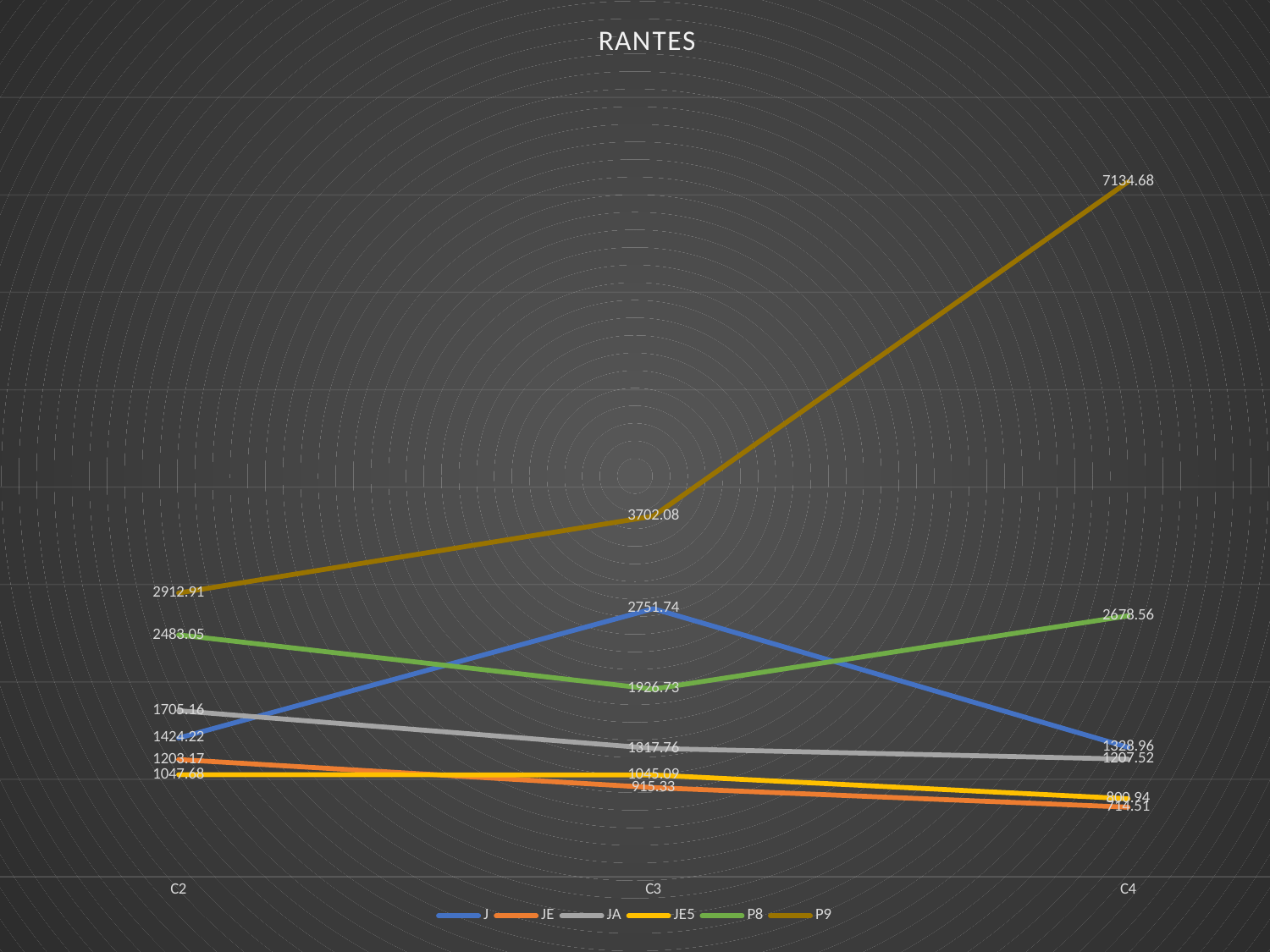
What is the value of J at C3? 2751.74 What is the value of P8 at C2? 2483.05 Which series has the lowest value at C4? JE What is the value of JA at C4? 1207.52 What is the value of P9 at C4? 7134.68 What is the title of the chart? RANTES What kind of chart is shown on the slide? line chart Which series has the highest value at C4? P9 Does the P9 series rise or fall from C2 to C4? rise What is the difference between the P9 values at C4 and C3? 3432.60 How many series does the legend list? 6 How many categories are shown on the x axis? 3